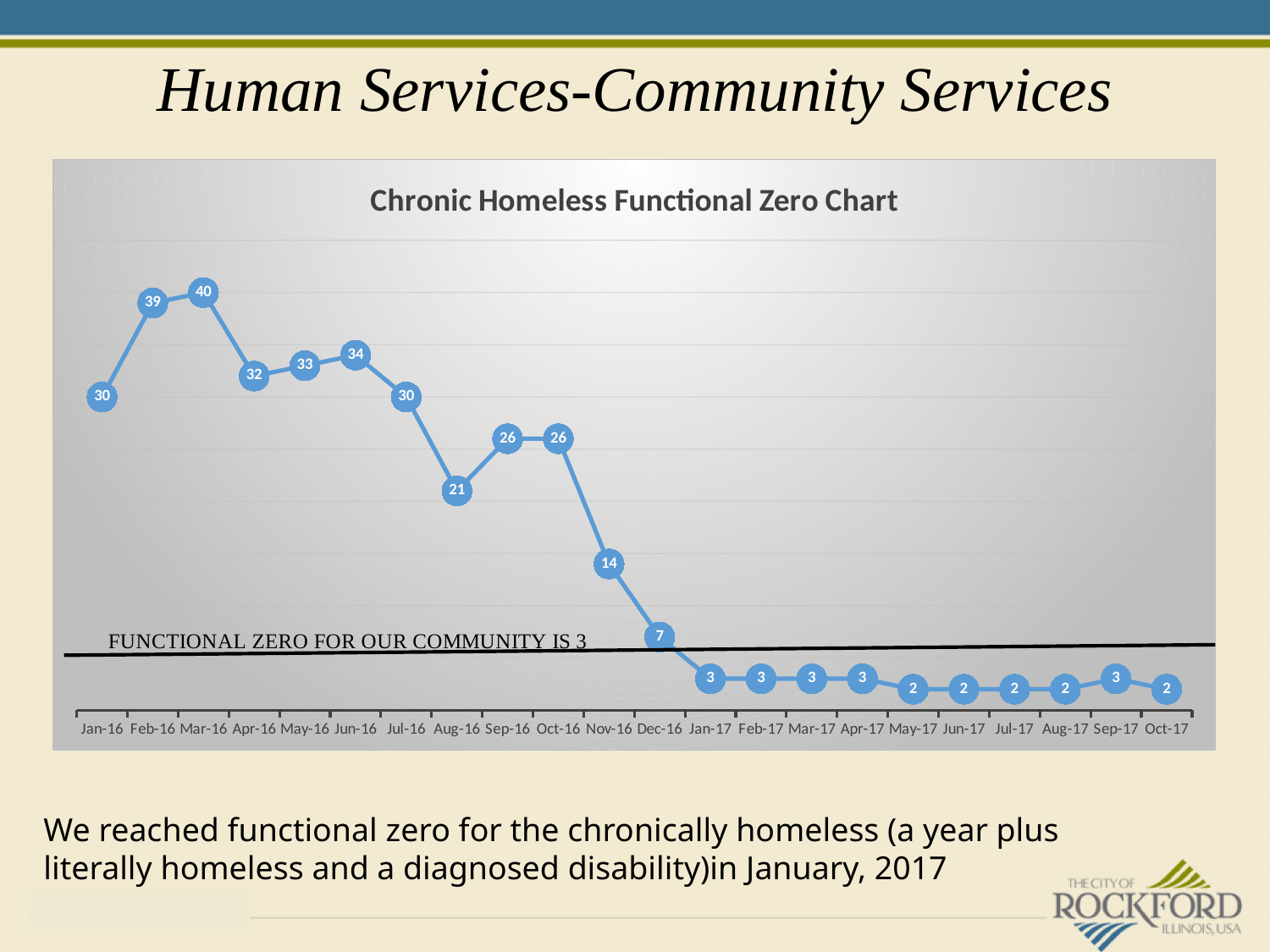
What is the value for Aug-16? 21 What is the value for Jan-17? 3 What is the value for Dec-16? 7 Do the values generally rise or fall from Jan-16 to Oct-17? fall Which month has the highest value? Mar-16 What is the difference between the values for Jan-16 and Jan-17? 27 Which is larger, the value for Jun-16 or the value for Nov-16? Jun-16 What type of chart is the Chronic Homeless Functional Zero Chart? line chart What is the value for Mar-16? 40 What is the difference between the values for Mar-16 and Oct-17? 38 What is the lowest value plotted on the chart? 2 How many data points are plotted on the chart? 22